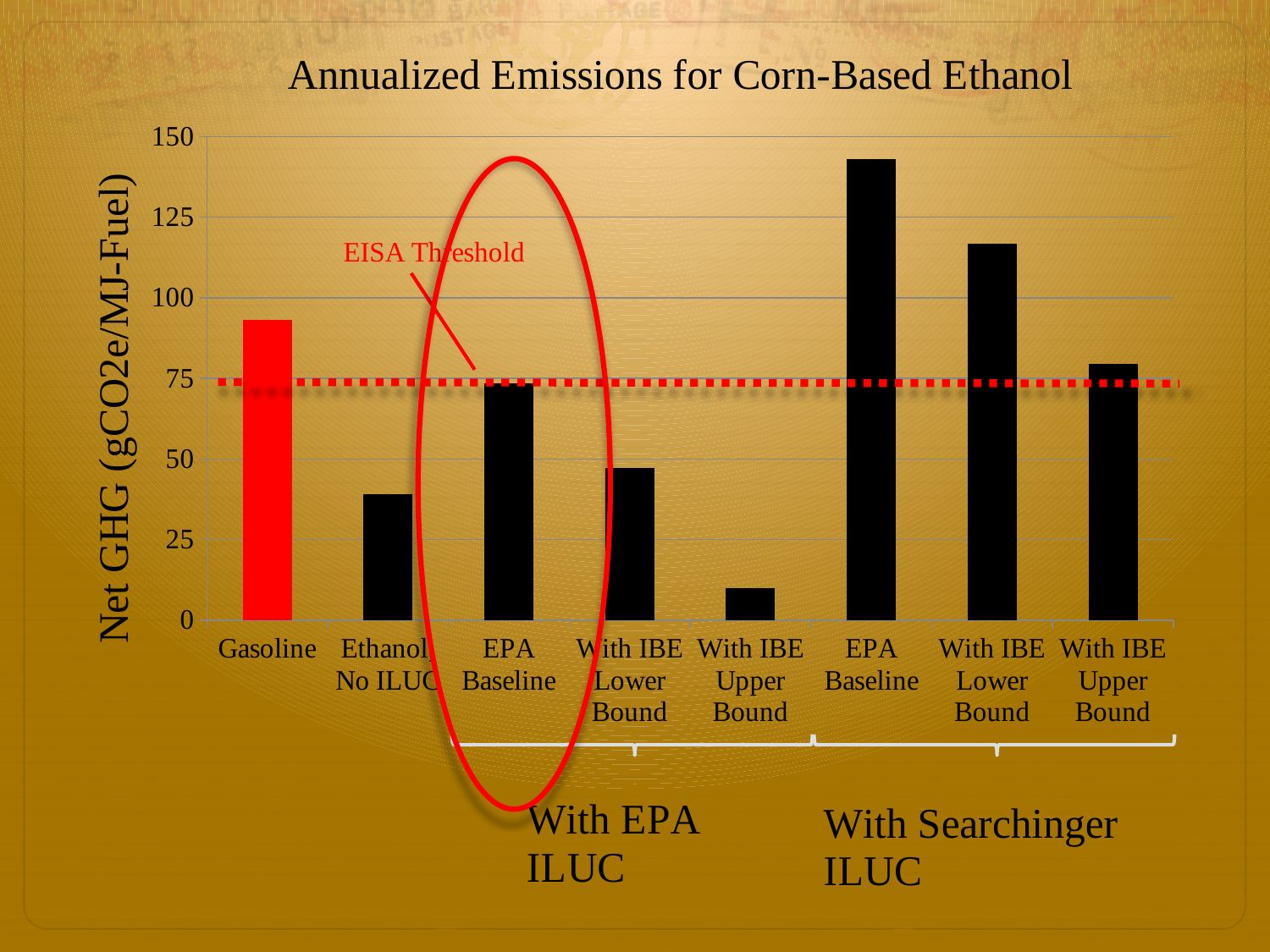
Is the value for Gasoline greater or less than 75? greater Is the value for With IBE Upper Bound under With EPA ILUC greater or less than 25? less How many bars are plotted in the chart? 8 Is the value for With IBE Lower Bound under With Searchinger ILUC greater or less than 100? greater Which bar has the highest Net GHG value? EPA Baseline (With Searchinger ILUC) What kind of chart is shown on the slide? bar chart What does the red dashed horizontal line on the chart represent? EISA Threshold Which bar has the lowest Net GHG value? With IBE Upper Bound (With EPA ILUC) Which is larger, the value for Gasoline or the value for Ethanol No ILUC? Gasoline What is the title of the chart? Annualized Emissions for Corn-Based Ethanol